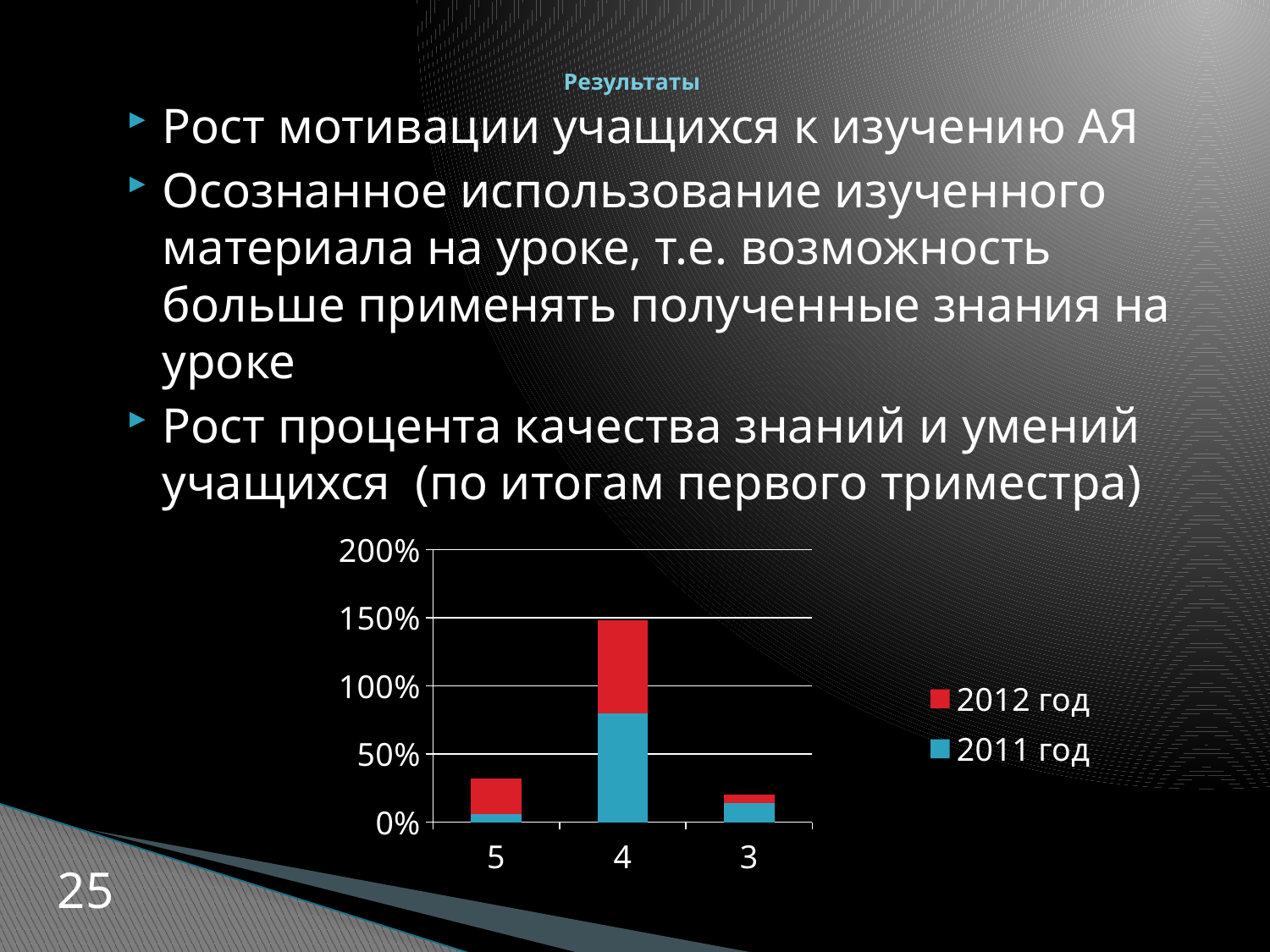
Which category has the tallest stacked bar in the chart? 4 Which colour represents the series 2012 год in the chart? red Is the total stacked value for category 4 greater or less than 100%? greater Is the 2011 год value for category 4 greater or less than 50%? greater Which category has the larger total stacked bar, 4 or 3? 4 How many series does the chart legend list? 2 Is the total stacked value for category 3 greater or less than 50%? less What kind of chart is shown on the slide? stacked bar chart Which category has the larger 2011 год value, 4 or 5? 4 How many categories are shown on the x axis of the chart? 3 What are the two series listed in the chart legend? 2012 год and 2011 год